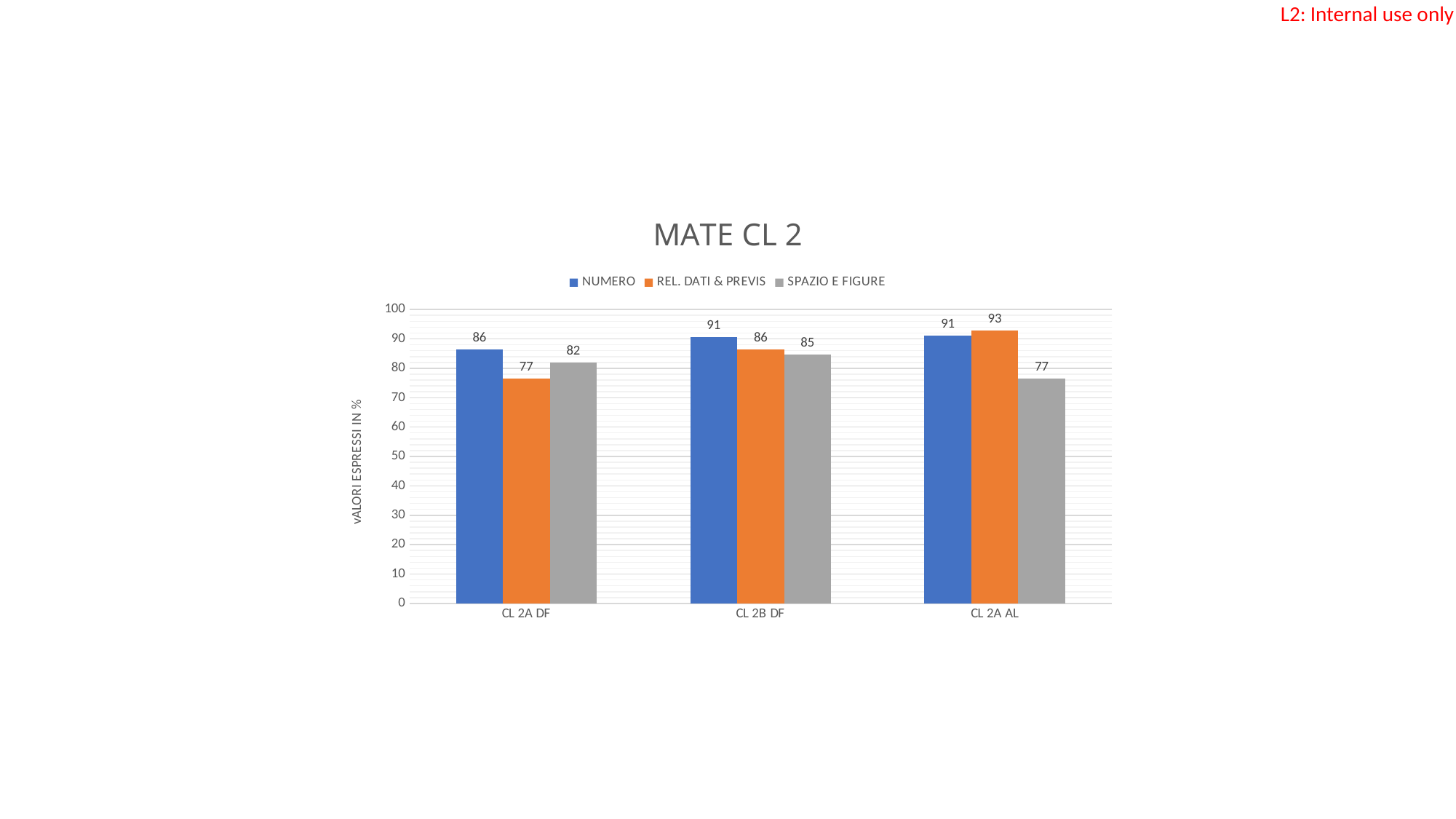
What is the value for SPAZIO E FIGURE in CL 2B DF? 85 Which category has the highest value for SPAZIO E FIGURE? CL 2B DF What is the label of the vertical axis? vALORI ESPRESSI IN % What is the value for NUMERO in CL 2A DF? 86 What kind of chart is shown? Bar chart Which is larger in CL 2A AL: NUMERO or SPAZIO E FIGURE? NUMERO What is the value for REL. DATI & PREVIS in CL 2A AL? 93 How many series does the legend list? 3 How many categories are shown on the x axis? 3 What is the difference between the NUMERO value and the REL. DATI & PREVIS value in CL 2A DF? 9 Which category has the lowest value for REL. DATI & PREVIS? CL 2A DF What is the title of the chart? MATE CL 2